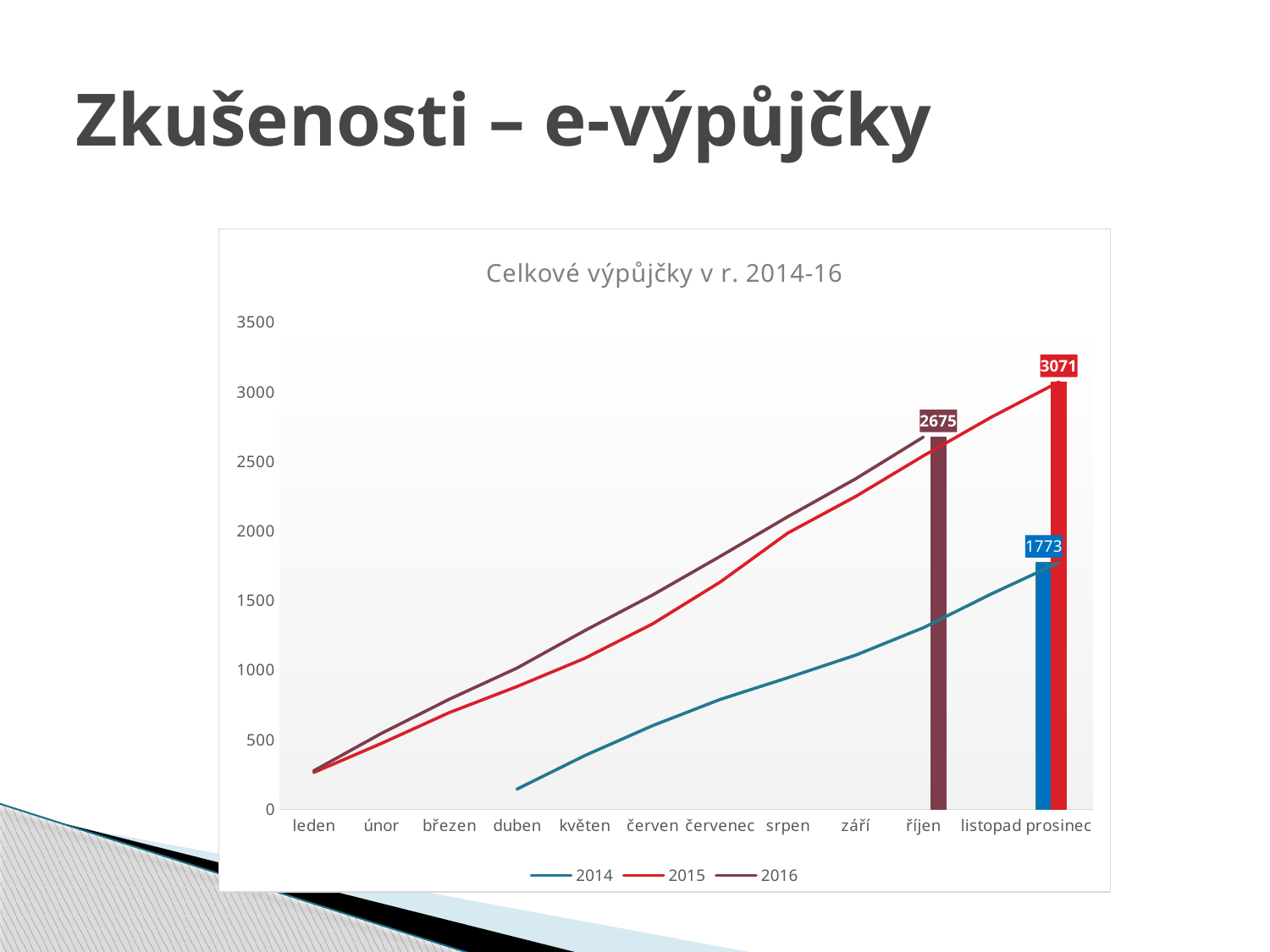
How many series does the chart legend list? 3 Which is larger, the labelled 2015 value in prosinec or the labelled 2016 value in říjen? 2015 in prosinec What is the difference between the labelled 2015 value (3071) and the labelled 2014 value (1773)? 1298 Do the values of the 2015 series rise or fall from leden to prosinec? rise What is the final labelled value for the 2014 series in prosinec? 1773 What is the title of the chart? Celkové výpůjčky v r. 2014-16 What is the labelled value for the 2016 series in říjen? 2675 How many months are shown on the x axis of the chart? 12 Is the value for the 2016 series in červenec greater or less than 1500? greater What is the final labelled value for the 2015 series in prosinec? 3071 Is the value for the 2014 series in srpen greater or less than 1000? less Which series are listed in the chart legend? 2014, 2015, 2016